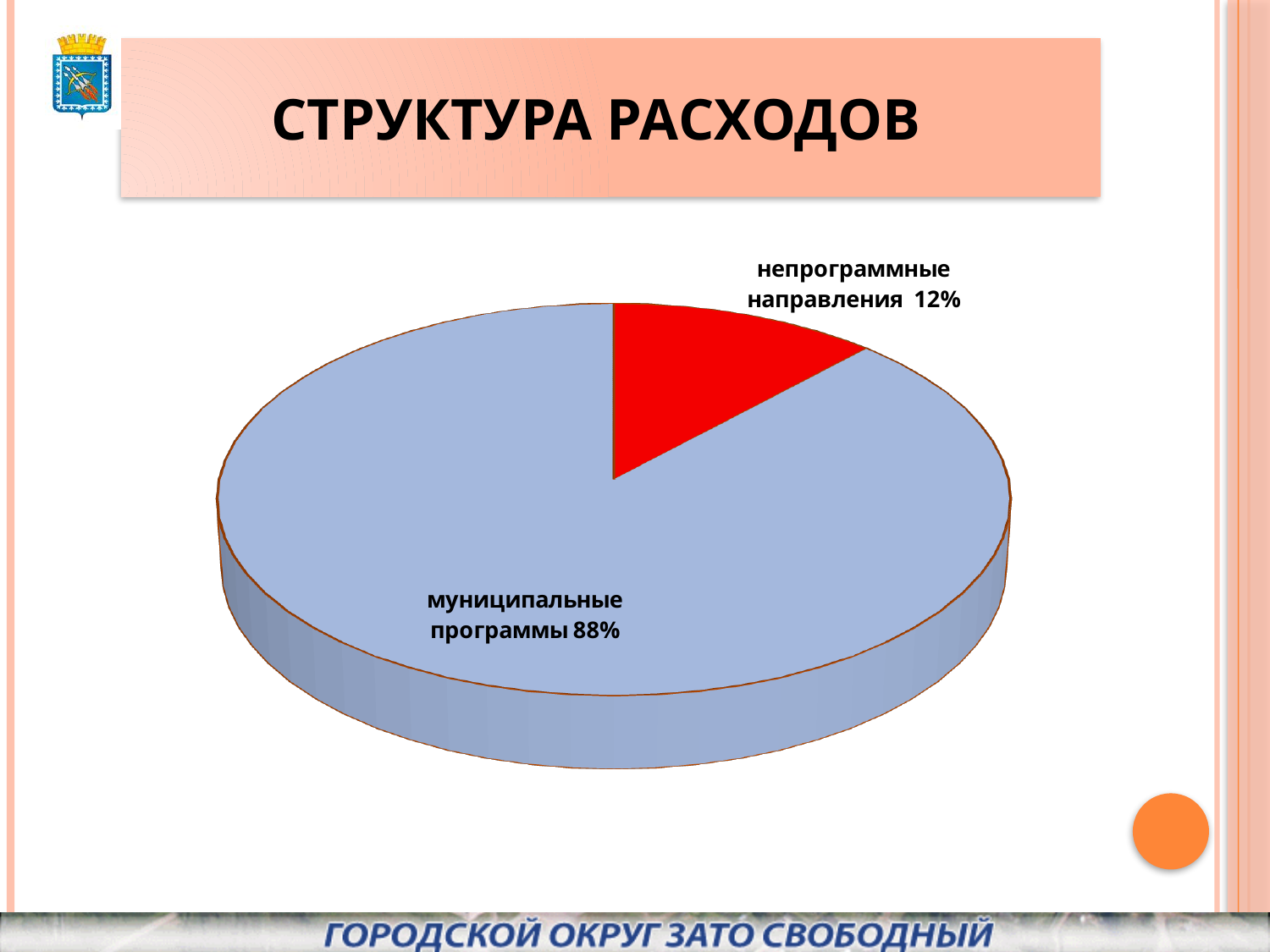
What share of the pie does "муниципальные программы" take? 88% What kind of chart is shown on the slide? pie chart What is the difference in percentage points between "муниципальные программы" and "непрограммные направления"? 76 How many slices does the pie chart have? 2 Which category has the largest slice of the pie? муниципальные программы What share of the pie does "непрограммные направления" take? 12% What colour is the slice for "непрограммные направления"? red Which category has the smallest slice of the pie? непрограммные направления Which is larger: the share for "муниципальные программы" or for "непрограммные направления"? муниципальные программы What is the title of the slide above the chart? СТРУКТУРА РАСХОДОВ